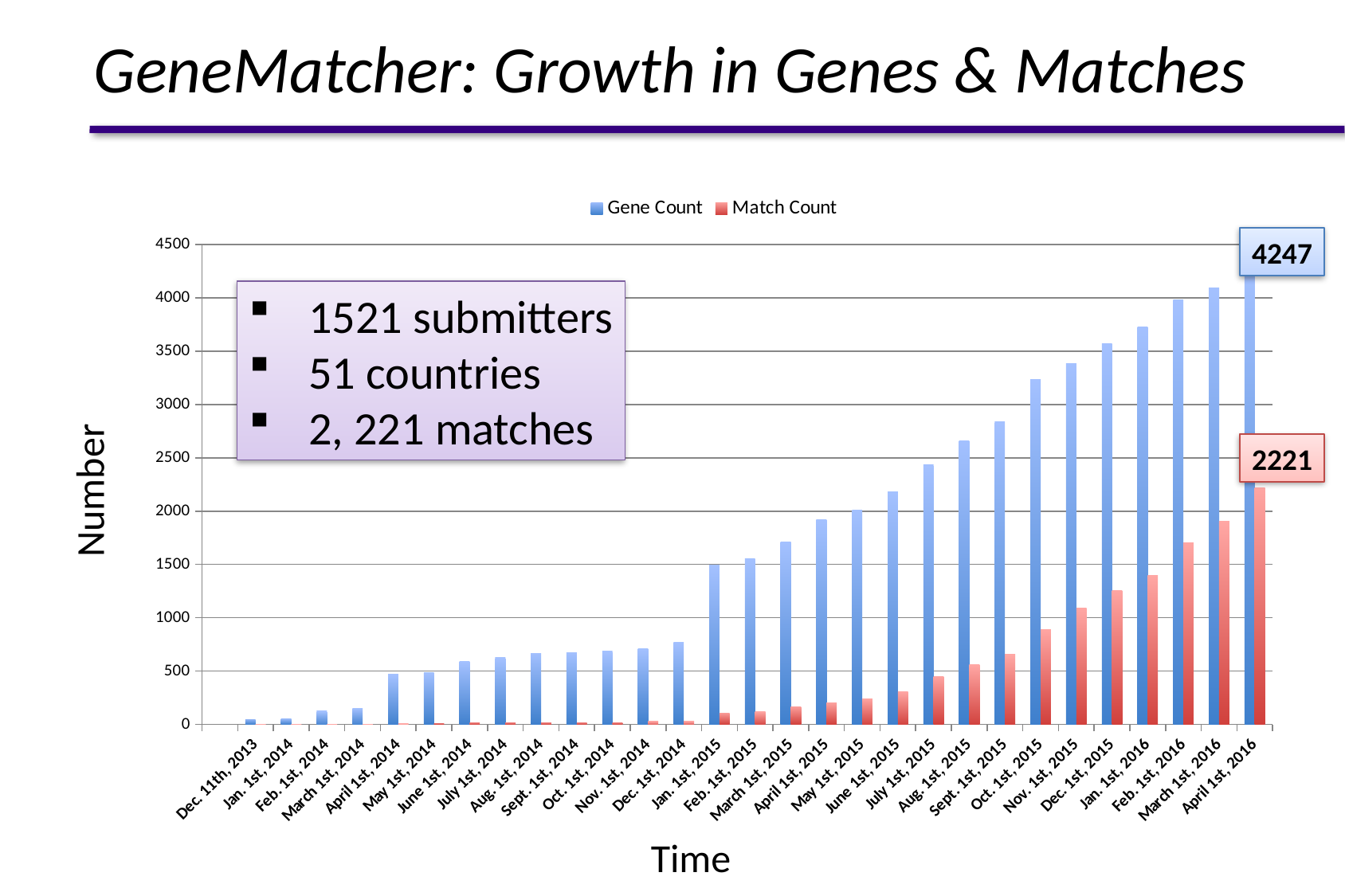
What is the Match Count on April 1st, 2016? 2221 Does the Gene Count rise or fall over time along the x axis? rise What is the difference between the Gene Count and the Match Count on April 1st, 2016? 2026 On April 1st, 2016, which is larger, the Gene Count or the Match Count? Gene Count How many series does the legend list? 2 Is the Match Count on Oct. 1st, 2015 greater or less than 1000? less Is the Gene Count on Dec. 1st, 2015 greater or less than 3500? greater Which date has the highest Gene Count? April 1st, 2016 What kind of chart is shown on the slide? bar chart What is the Gene Count on April 1st, 2016? 4247